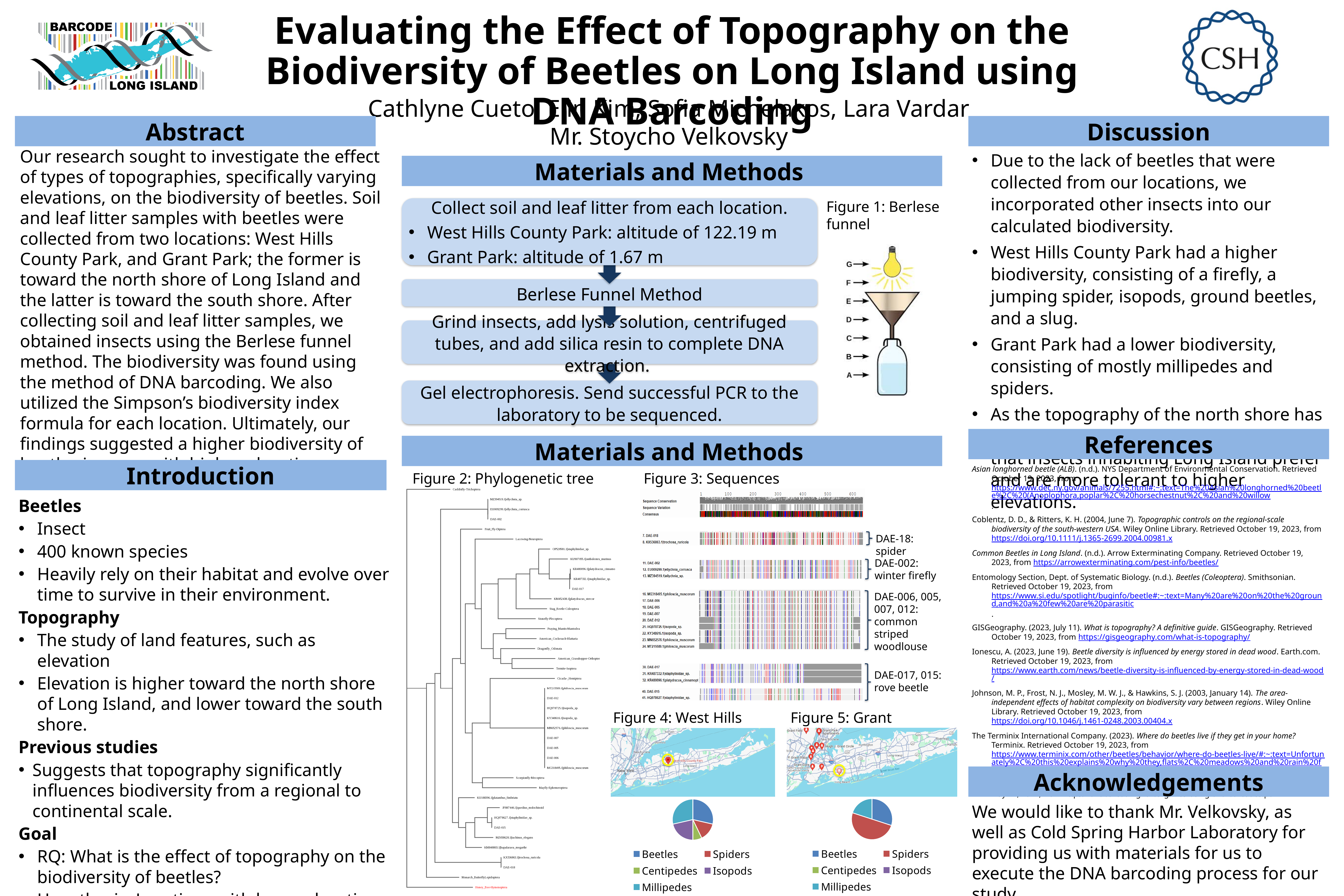
How many categories does the legend of the Figure 4: West Hills pie chart list? 5 What kind of chart is shown under Figure 5: Grant? pie chart In the Figure 4: West Hills pie chart, which slice is larger, Millipedes or Centipedes? Millipedes In the Figure 5: Grant pie chart, which slice is larger, Spiders or Beetles? Spiders What kind of chart is shown under Figure 4: West Hills? pie chart What colour represents Spiders in the legend of the Figure 5: Grant pie chart? red In the Figure 5: Grant pie chart, which category has the largest slice? Spiders How many categories does the legend of the Figure 5: Grant pie chart list? 5 What colour represents Beetles in the legend of the Figure 4: West Hills pie chart? blue In the Figure 5: Grant pie chart, which slice is larger, Spiders or Millipedes? Spiders